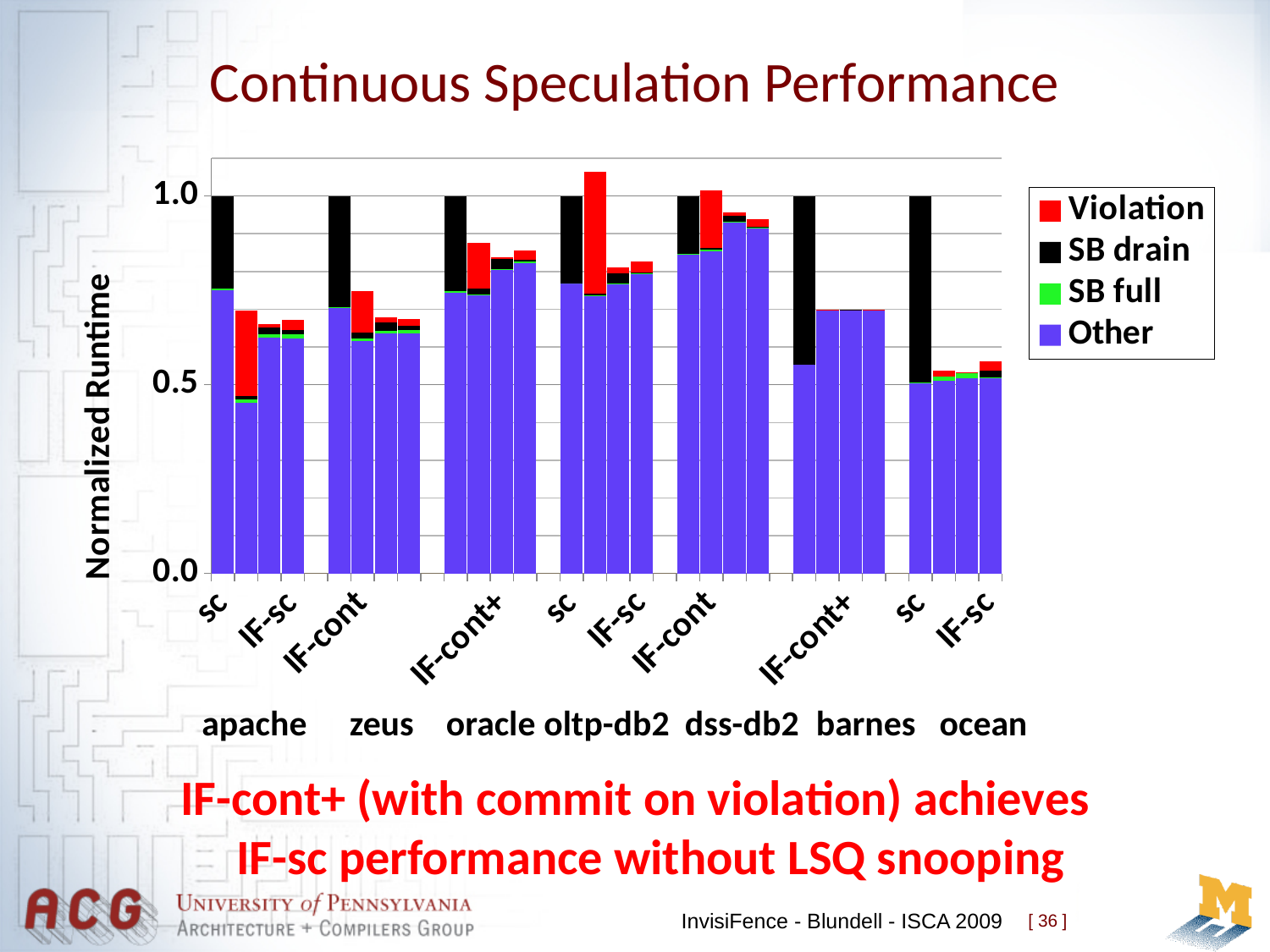
For barnes, which bar has the larger total: sc or IF-cont+? sc How many bars are plotted for each benchmark group? 4 Is the total height of the IF-cont+ bar for apache greater or less than 0.5? greater How many benchmark groups are shown along the x axis? 7 What kind of chart is shown on the slide? stacked bar chart Is the total height of the IF-sc bar for barnes greater or less than 1.0? less What is the label of the vertical axis? Normalized Runtime Which benchmark has the lowest total for its IF-cont+ bar? ocean How many series does the legend list? 4 Which series is shown in red in the legend? Violation Is the total height of the IF-sc bar for oltp-db2 greater or less than 1.0? less For apache, which bar has the larger total: sc or IF-sc? sc